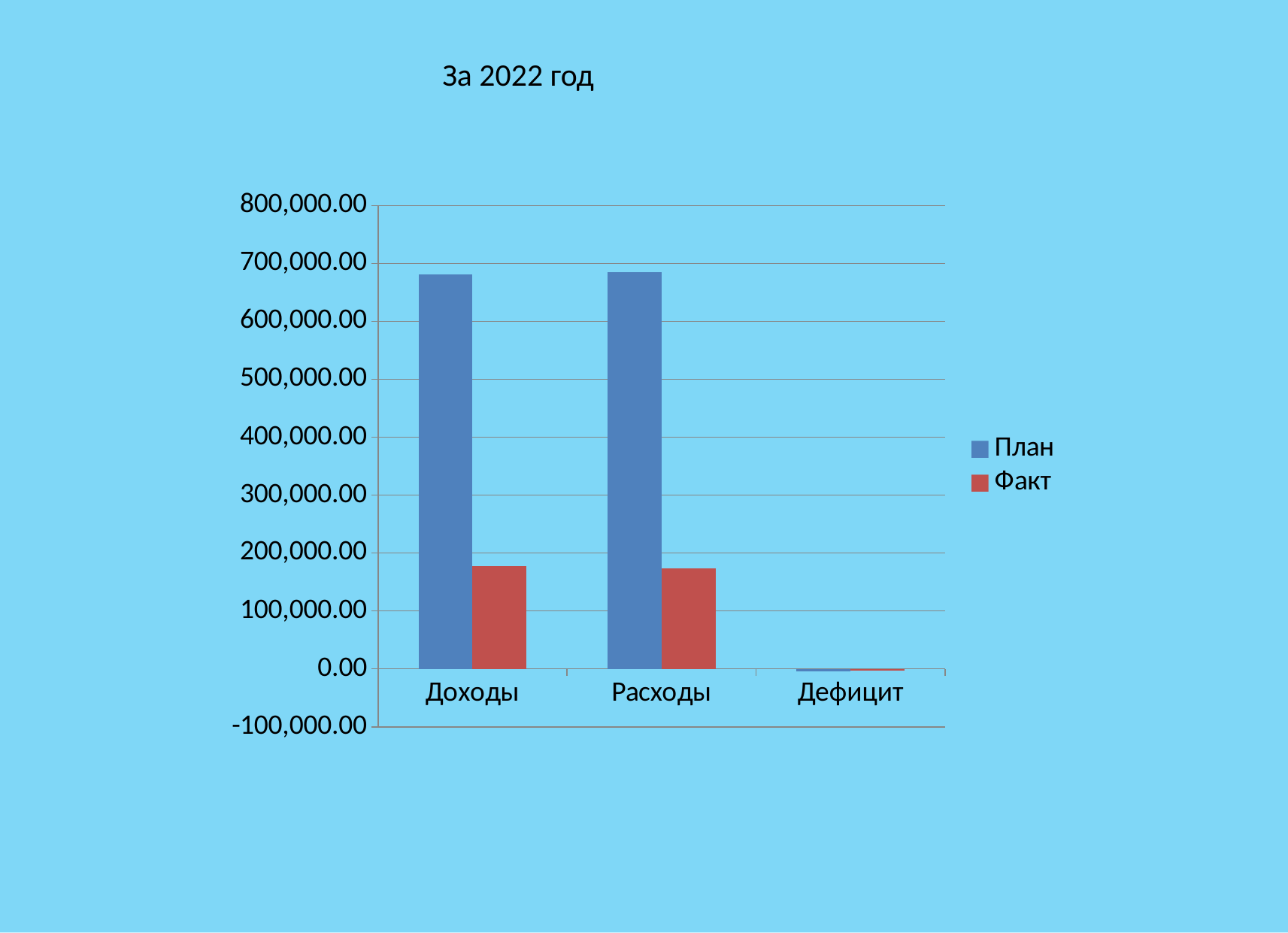
Is the План value for Доходы greater or less than 600,000.00? greater Is the План value for Дефицит greater or less than 100,000.00? less Is the План value for Расходы greater or less than 700,000.00? less Which category has the lowest План value? Дефицит For Доходы, which is larger: the План value or the Факт value? План How many categories are shown on the x axis? 3 Which series is shown in red? Факт What is the title of the chart? За 2022 год What type of chart is shown on the slide? bar chart How many series does the legend list? 2